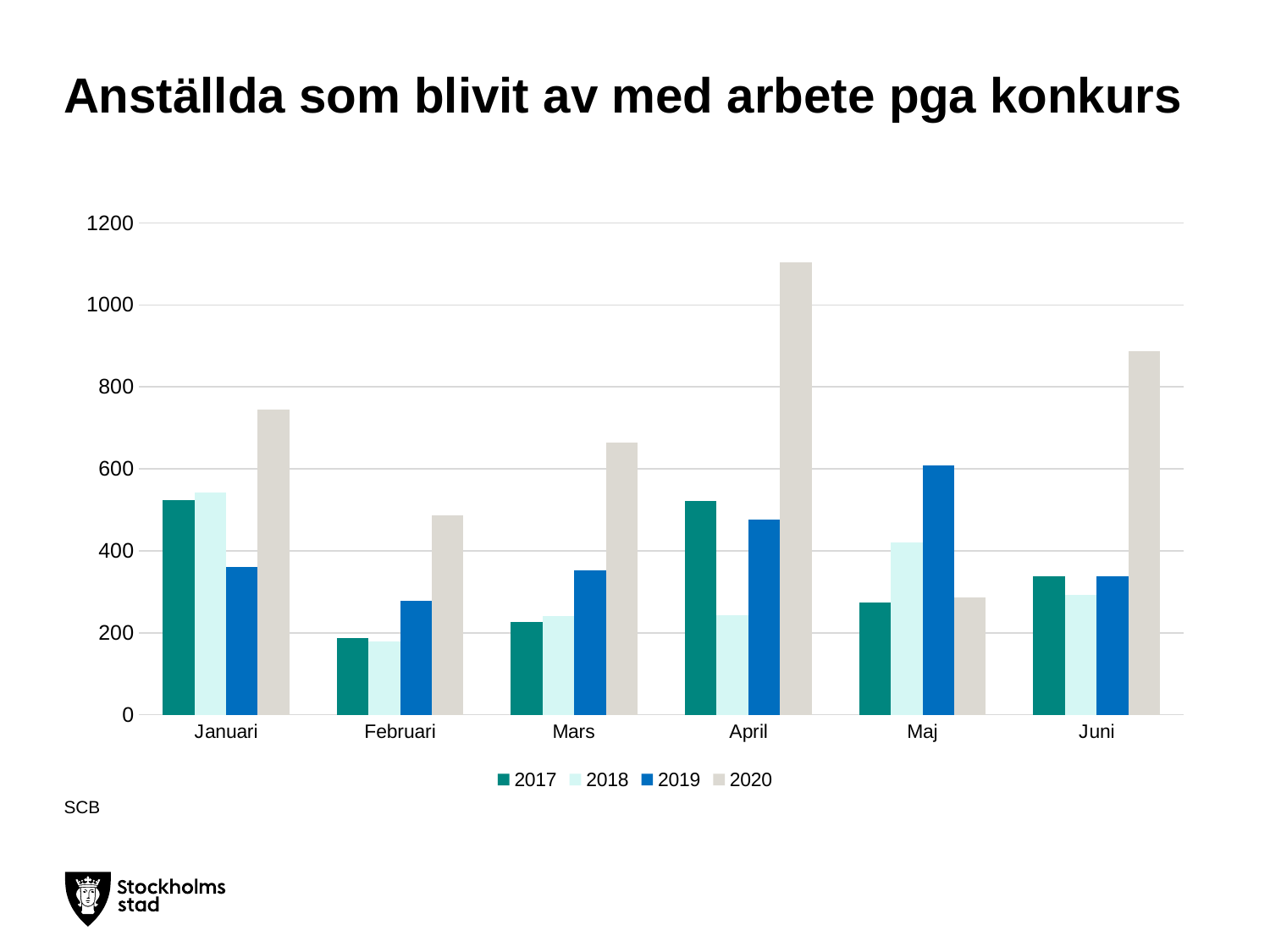
Which month has the highest value for 2020? April Which is larger: the 2020 value for Januari or the 2020 value for Juni? Juni In Maj, which is larger: the value for 2019 or the value for 2020? 2019 What is the title of the chart? Anställda som blivit av med arbete pga konkurs How many months are shown on the x axis? 6 Is the value for 2019 in Februari greater or less than 400? less Which month has the lowest value for 2020? Maj In Maj, which series has the highest value? 2019 What kind of chart is shown on the slide? bar chart Is the value for 2020 in Mars greater or less than 600? greater How many series does the legend list? 4 Is the value for 2020 in April greater or less than 1000? greater